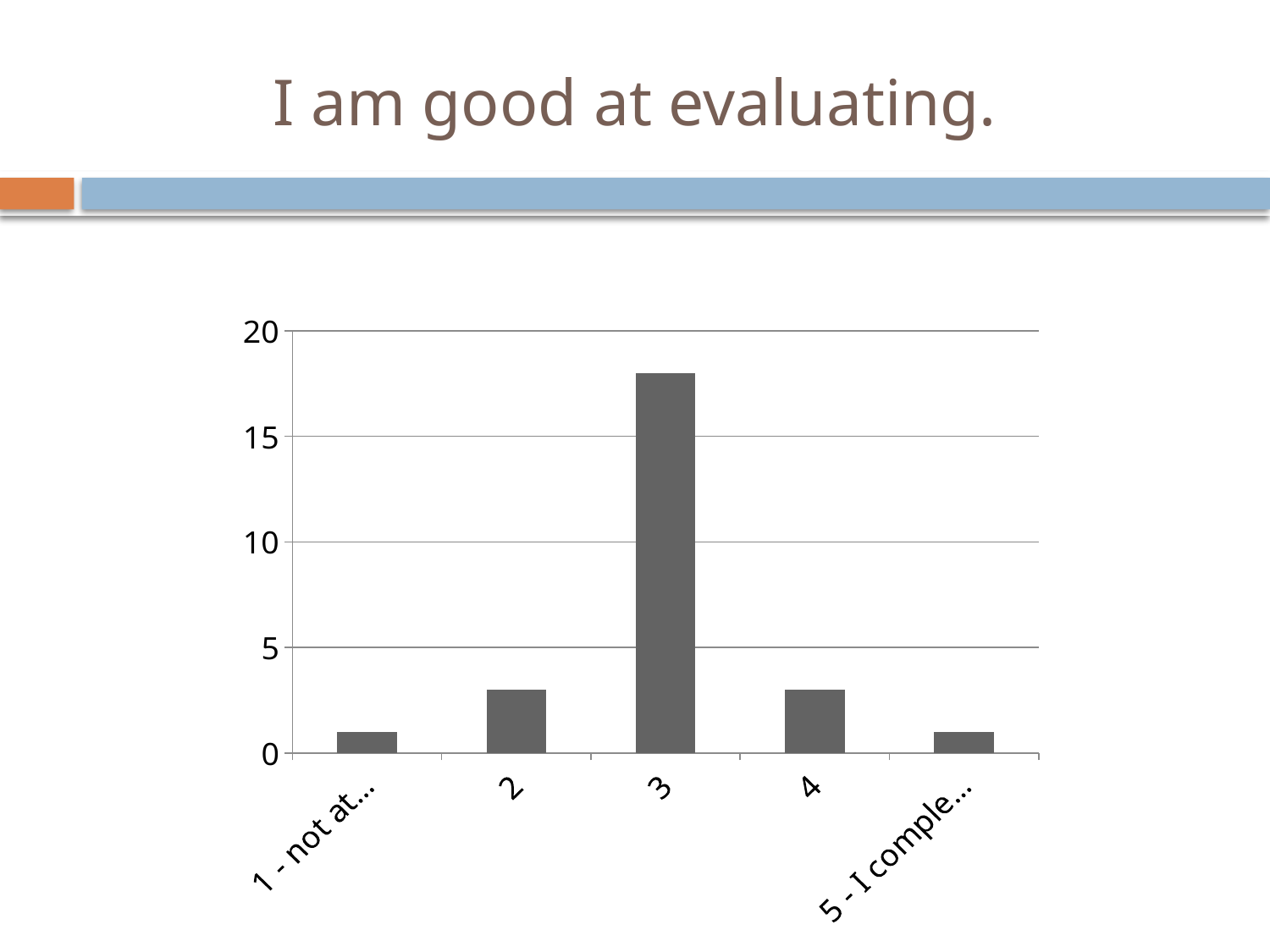
What is the highest value shown on the vertical axis of the chart? 20 Which has the larger value, category 4 or category 3? 3 Which has the larger value, category 3 or category 2? 3 How many categories are shown on the x axis of the chart? 5 What is the title of the slide containing the chart? I am good at evaluating. Is the value for the first category (1 - not at...) greater or less than 5? less Is the value for category 3 greater or less than 15? greater Is the value for category 3 greater or less than 20? less Which category has the highest bar in the chart? 3 What kind of chart is shown on the slide? bar chart